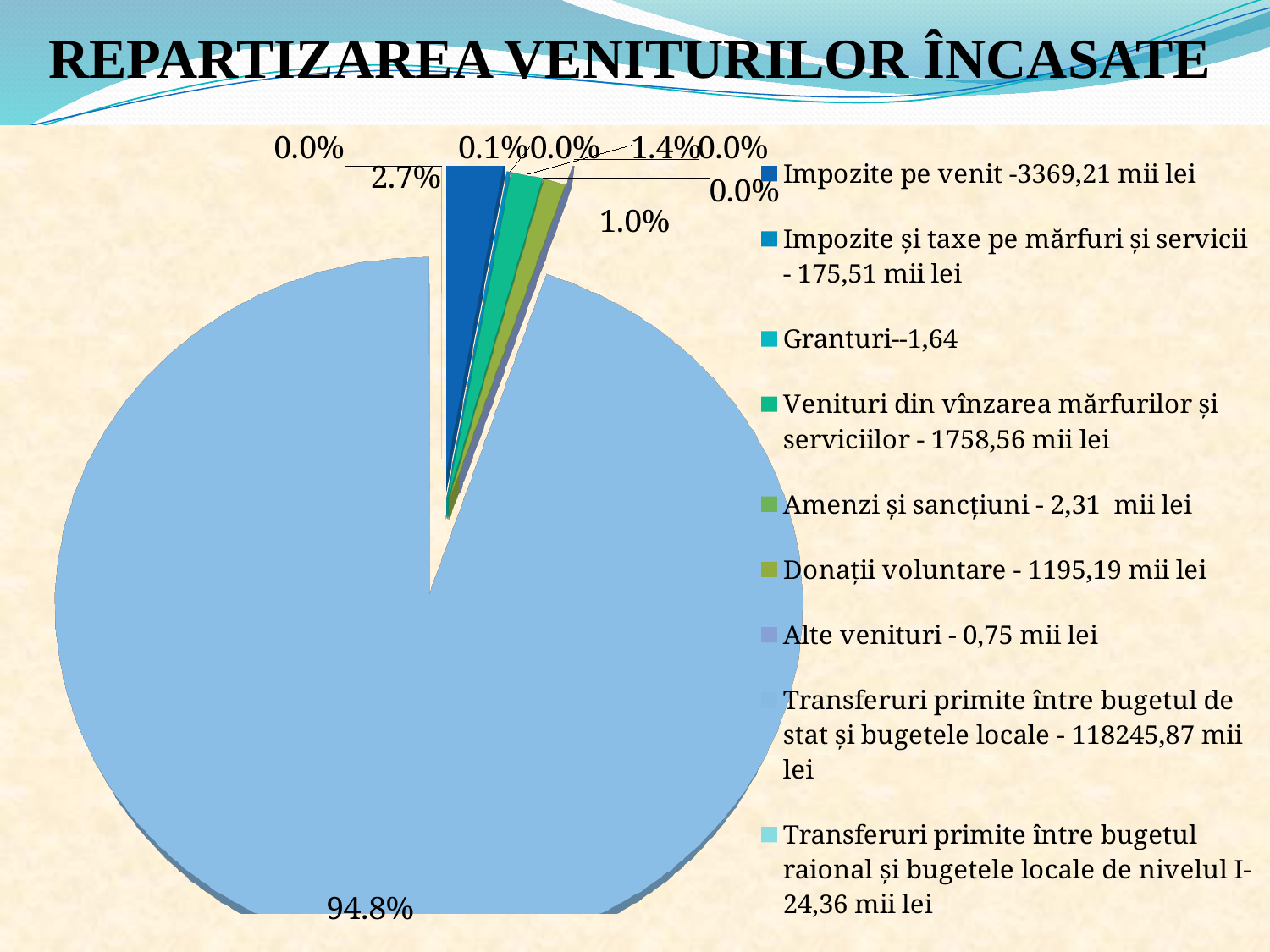
What share of the pie does 'Impozite pe venit' represent? 2.7% What share of the pie does 'Transferuri primite între bugetul de stat și bugetele locale' represent? 94.8% Which slice is larger: 'Impozite pe venit' or 'Donații voluntare'? Impozite pe venit According to the legend, what amount in mii lei is given for 'Impozite pe venit'? 3369,21 mii lei What is the difference in percentage points between the 'Transferuri primite între bugetul de stat și bugetele locale' slice and the 'Impozite pe venit' slice? 92.1% What type of chart is shown on the slide? Pie chart How many categories does the legend list? 9 What is the title of the slide? REPARTIZAREA VENITURILOR ÎNCASATE Which slice is larger: 'Venituri din vînzarea mărfurilor și serviciilor' or 'Donații voluntare'? Venituri din vînzarea mărfurilor și serviciilor What share of the pie does 'Venituri din vînzarea mărfurilor și serviciilor' represent? 1.4% Which category has the largest slice of the pie? Transferuri primite între bugetul de stat și bugetele locale